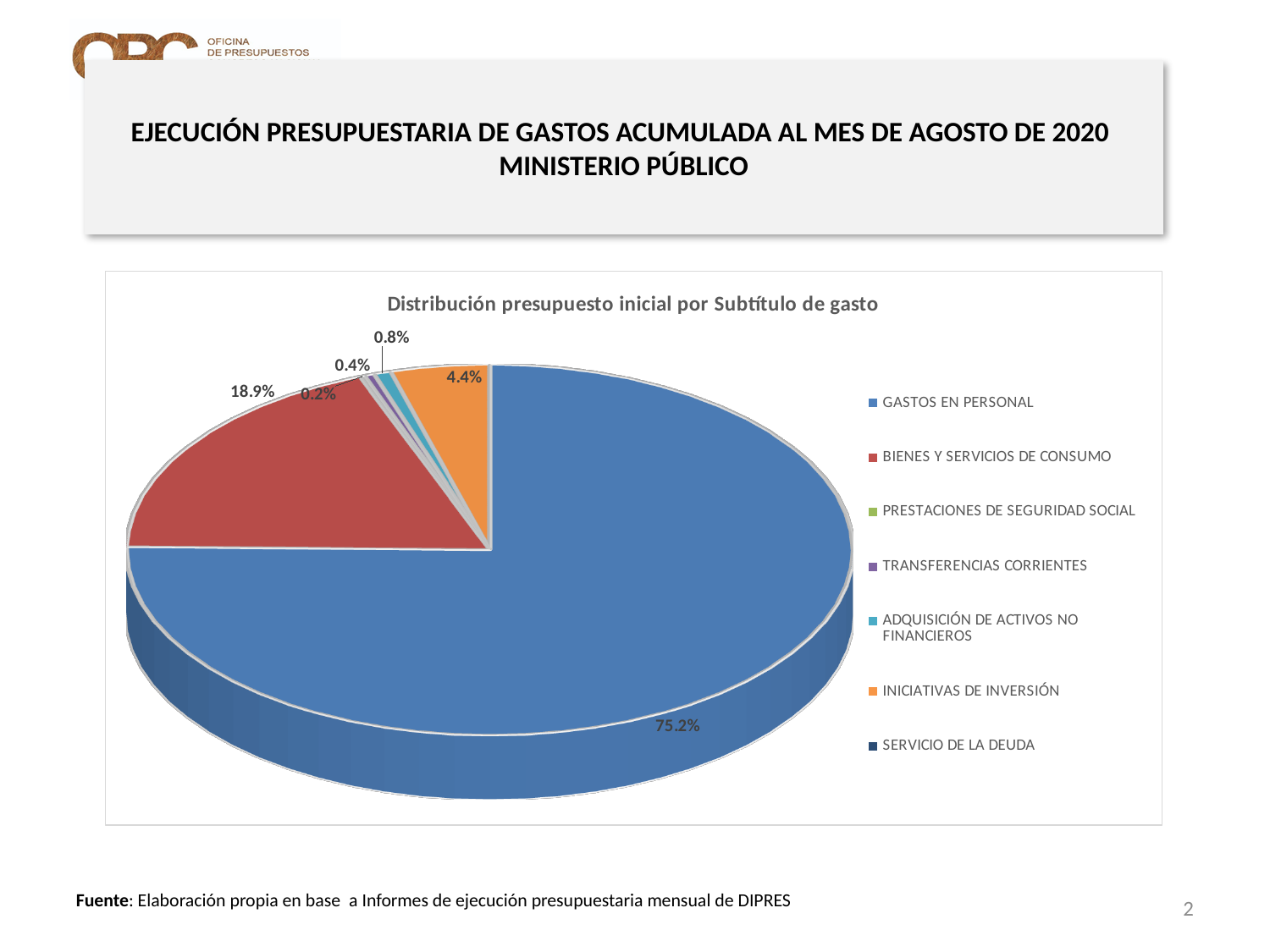
What kind of chart is shown on the slide? pie chart What is the title of the chart? Distribución presupuesto inicial por Subtítulo de gasto Which category has the largest slice of the pie? GASTOS EN PERSONAL What is the difference between the shares of GASTOS EN PERSONAL and BIENES Y SERVICIOS DE CONSUMO? 56.3% What share of the pie does GASTOS EN PERSONAL represent? 75.2% What colour is the slice for BIENES Y SERVICIOS DE CONSUMO? red What is the value shown for INICIATIVAS DE INVERSIÓN? 4.4% How many entries does the chart legend list? 7 What is the value shown for BIENES Y SERVICIOS DE CONSUMO? 18.9% What is the value shown for ADQUISICIÓN DE ACTIVOS NO FINANCIEROS? 0.8% Which is larger, the share for INICIATIVAS DE INVERSIÓN or the share for ADQUISICIÓN DE ACTIVOS NO FINANCIEROS? INICIATIVAS DE INVERSIÓN What is the value shown for TRANSFERENCIAS CORRIENTES? 0.4%